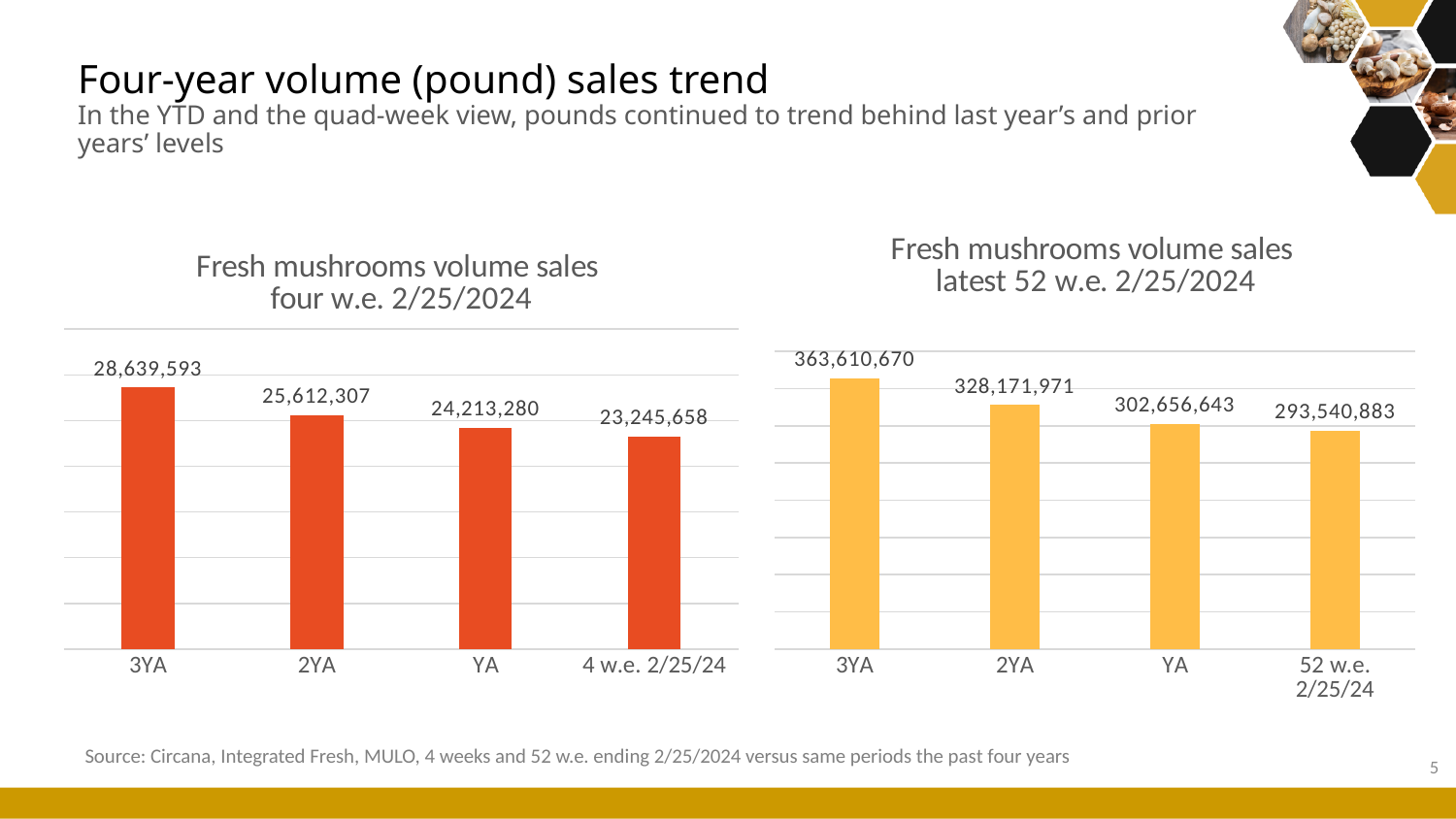
In the 'Fresh mushrooms volume sales four w.e. 2/25/2024' chart, what is the difference between the 3YA value and the 4 w.e. 2/25/24 value? 5,393,935 In the 'Fresh mushrooms volume sales latest 52 w.e. 2/25/2024' chart, what is the value for YA? 302,656,643 In the 'Fresh mushrooms volume sales four w.e. 2/25/2024' chart, what is the value for 3YA? 28,639,593 In the 'Fresh mushrooms volume sales four w.e. 2/25/2024' chart, which is larger, the value for 2YA or the value for YA? 2YA How many bars are in the 'Fresh mushrooms volume sales latest 52 w.e. 2/25/2024' chart? 4 In the 'Fresh mushrooms volume sales latest 52 w.e. 2/25/2024' chart, what is the value for 2YA? 328,171,971 In the 'Fresh mushrooms volume sales four w.e. 2/25/2024' chart, which category has the lowest value? 4 w.e. 2/25/24 In the 'Fresh mushrooms volume sales four w.e. 2/25/2024' chart, what is the value for 4 w.e. 2/25/24? 23,245,658 In the 'Fresh mushrooms volume sales latest 52 w.e. 2/25/2024' chart, do the values rise or fall from 3YA to 52 w.e. 2/25/24? Fall What type of chart is the 'Fresh mushrooms volume sales four w.e. 2/25/2024' chart? Bar chart In the 'Fresh mushrooms volume sales latest 52 w.e. 2/25/2024' chart, which category has the highest value? 3YA In the 'Fresh mushrooms volume sales latest 52 w.e. 2/25/2024' chart, what is the difference between the YA value and the 52 w.e. 2/25/24 value? 9,115,760